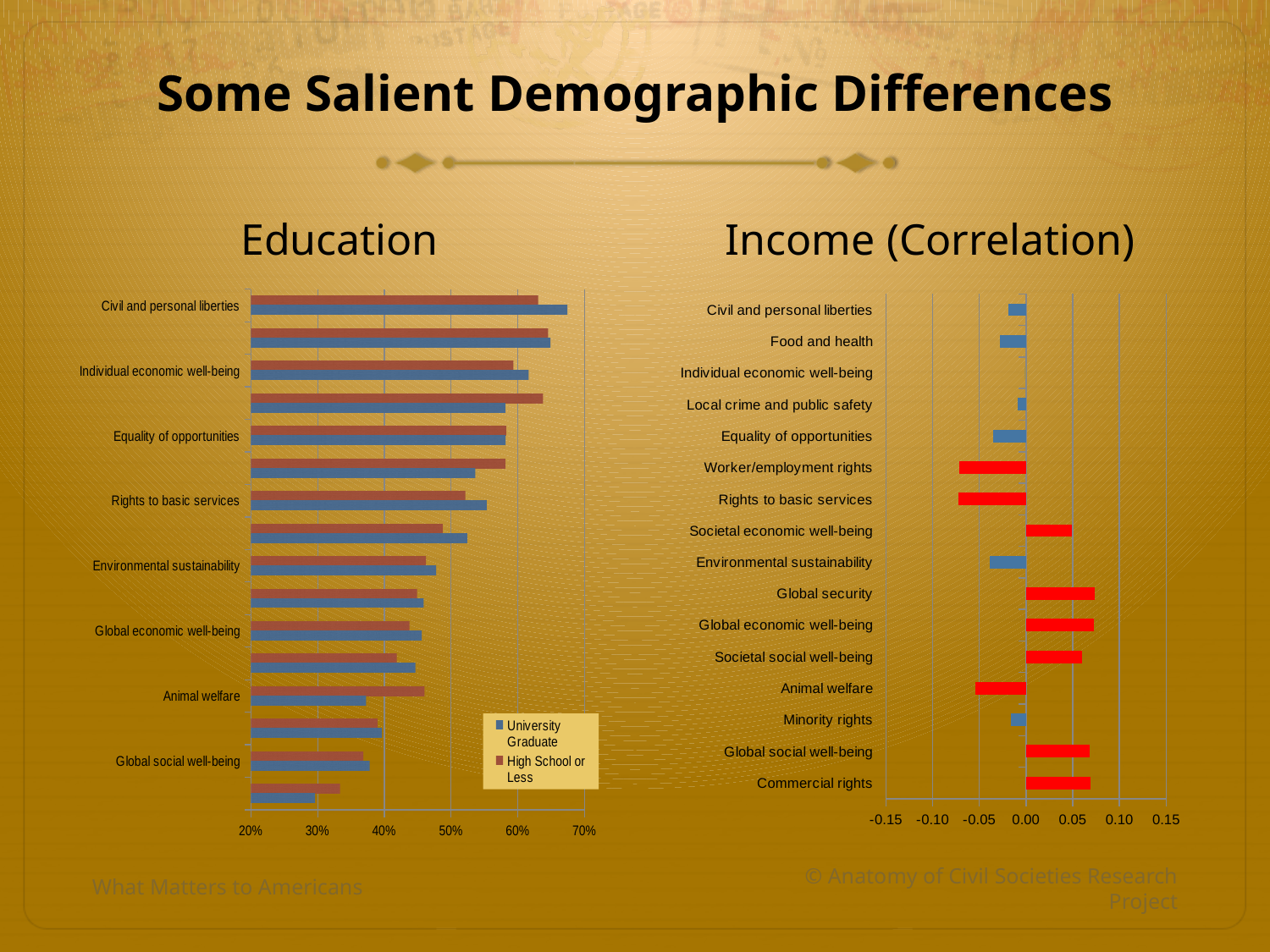
On the Income (Correlation) chart, is the value for Global security greater or less than 0.05? greater On the Income (Correlation) chart, which is larger, the value for Societal economic well-being or the value for Environmental sustainability? Societal economic well-being How many series does the legend of the Education chart list? 2 How many categories are plotted on the Income (Correlation) chart? 16 What kind of chart is the Education chart? bar chart On the Income (Correlation) chart, which is larger, the value for Commercial rights or the value for Animal welfare? Commercial rights On the Income (Correlation) chart, is the value for Worker/employment rights greater or less than -0.05? less What are the two series named in the legend of the Education chart? University Graduate and High School or Less On the Income (Correlation) chart, is the value for Food and health greater or less than 0.00? less On the Education chart, for Animal welfare, which series has the larger value, University Graduate or High School or Less? High School or Less